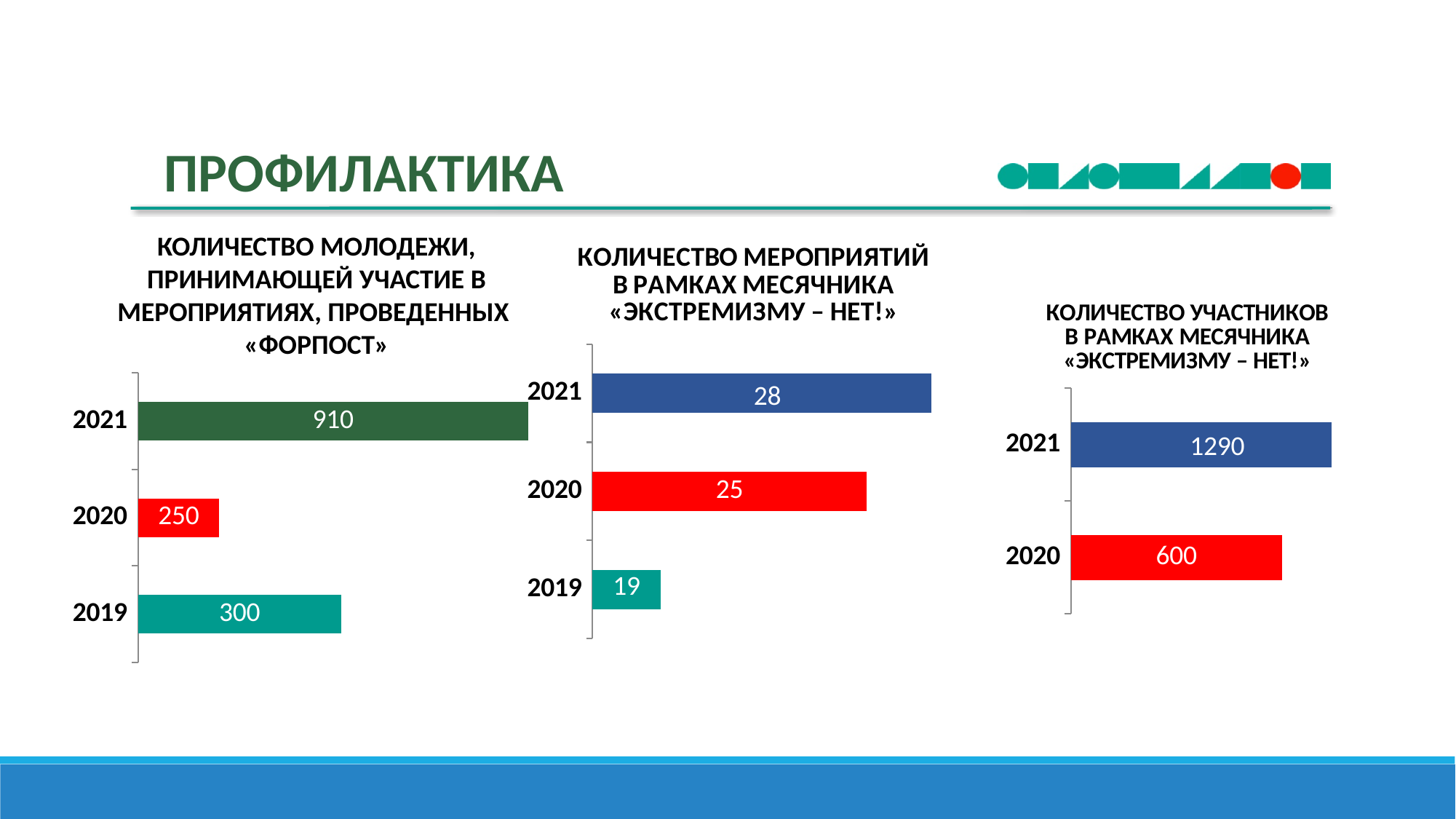
In the right chart (КОЛИЧЕСТВО УЧАСТНИКОВ В РАМКАХ МЕСЯЧНИКА «ЭКСТРЕМИЗМУ – НЕТ!»), which is larger, the value for 2021 or 2020? 2021 In the left chart (КОЛИЧЕСТВО МОЛОДЕЖИ ... «ФОРПОСТ»), how many years are shown? 3 In the middle chart (КОЛИЧЕСТВО МЕРОПРИЯТИЙ В РАМКАХ МЕСЯЧНИКА «ЭКСТРЕМИЗМУ – НЕТ!»), what is the value for 2019? 19 In the middle chart (КОЛИЧЕСТВО МЕРОПРИЯТИЙ В РАМКАХ МЕСЯЧНИКА «ЭКСТРЕМИЗМУ – НЕТ!»), which year has the highest value? 2021 In the left chart (КОЛИЧЕСТВО МОЛОДЕЖИ ... «ФОРПОСТ»), which year has the lowest value? 2020 In the right chart (КОЛИЧЕСТВО УЧАСТНИКОВ В РАМКАХ МЕСЯЧНИКА «ЭКСТРЕМИЗМУ – НЕТ!»), what is the difference between the values for 2021 and 2020? 690 In the right chart (КОЛИЧЕСТВО УЧАСТНИКОВ В РАМКАХ МЕСЯЧНИКА «ЭКСТРЕМИЗМУ – НЕТ!»), what is the value for 2020? 600 In the middle chart (КОЛИЧЕСТВО МЕРОПРИЯТИЙ В РАМКАХ МЕСЯЧНИКА «ЭКСТРЕМИЗМУ – НЕТ!»), do the values rise or fall from 2019 to 2021? rise In the left chart (КОЛИЧЕСТВО МОЛОДЕЖИ, ПРИНИМАЮЩЕЙ УЧАСТИЕ В МЕРОПРИЯТИЯХ, ПРОВЕДЕННЫХ «ФОРПОСТ»), what is the value for 2021? 910 What kind of chart is the right chart (КОЛИЧЕСТВО УЧАСТНИКОВ В РАМКАХ МЕСЯЧНИКА «ЭКСТРЕМИЗМУ – НЕТ!»)? bar chart In the middle chart (КОЛИЧЕСТВО МЕРОПРИЯТИЙ В РАМКАХ МЕСЯЧНИКА «ЭКСТРЕМИЗМУ – НЕТ!»), what is the difference between the values for 2021 and 2020? 3 In the left chart (КОЛИЧЕСТВО МОЛОДЕЖИ ... «ФОРПОСТ»), what is the difference between the values for 2021 and 2019? 610